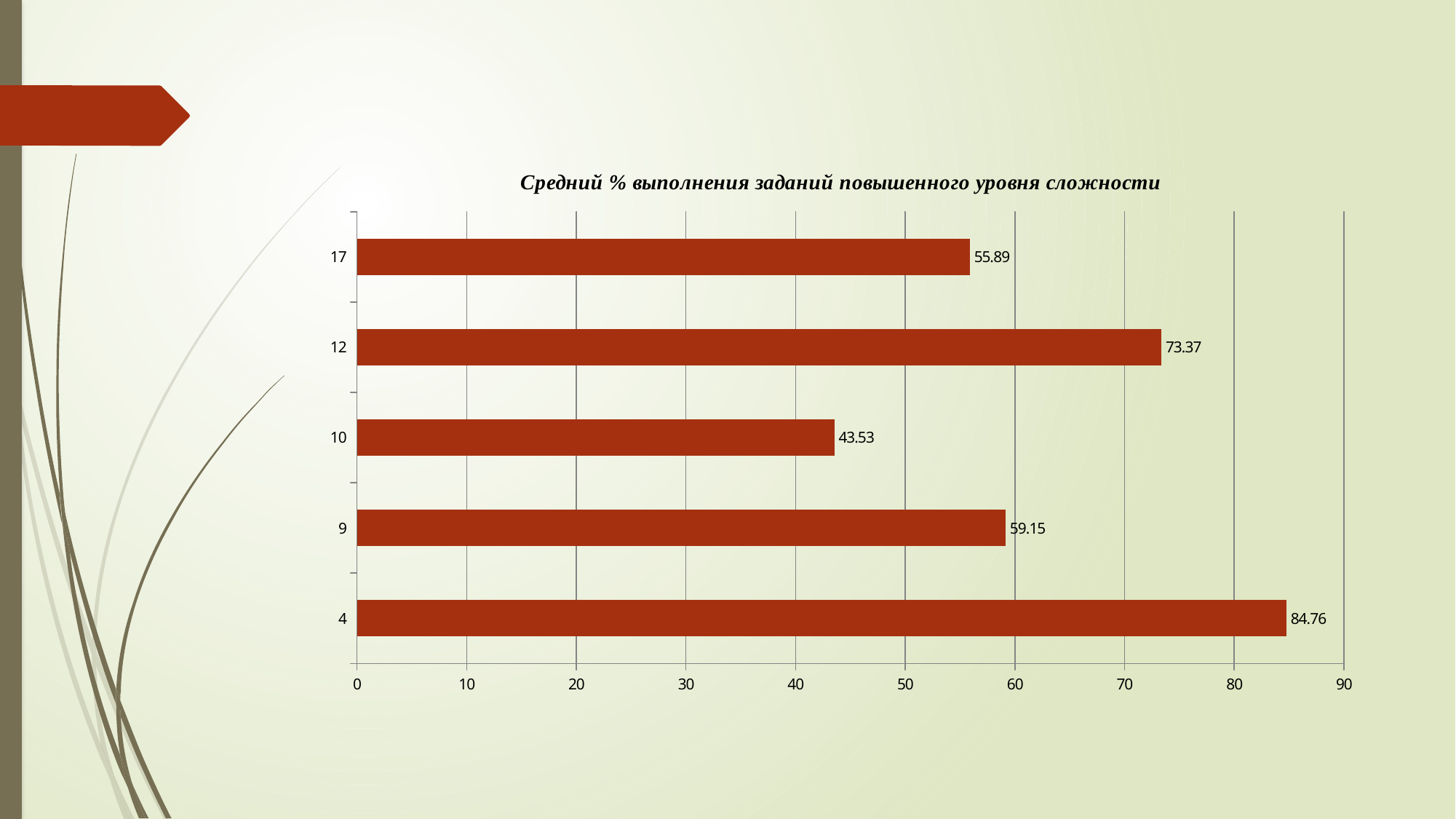
Which category has the highest value? 4 What is the value for category 10? 43.53 What is the difference between the values for category 4 and category 10? 41.23 What is the value for category 12? 73.37 Is the value for category 12 greater or less than 70? greater What is the title of the chart? Средний % выполнения заданий повышенного уровня сложности What is the value for category 4? 84.76 What is the value for category 17? 55.89 Which has a larger value, category 9 or category 17? 9 Which category has the lowest value? 10 How many categories are shown in the chart? 5 What kind of chart is shown on the slide? bar chart